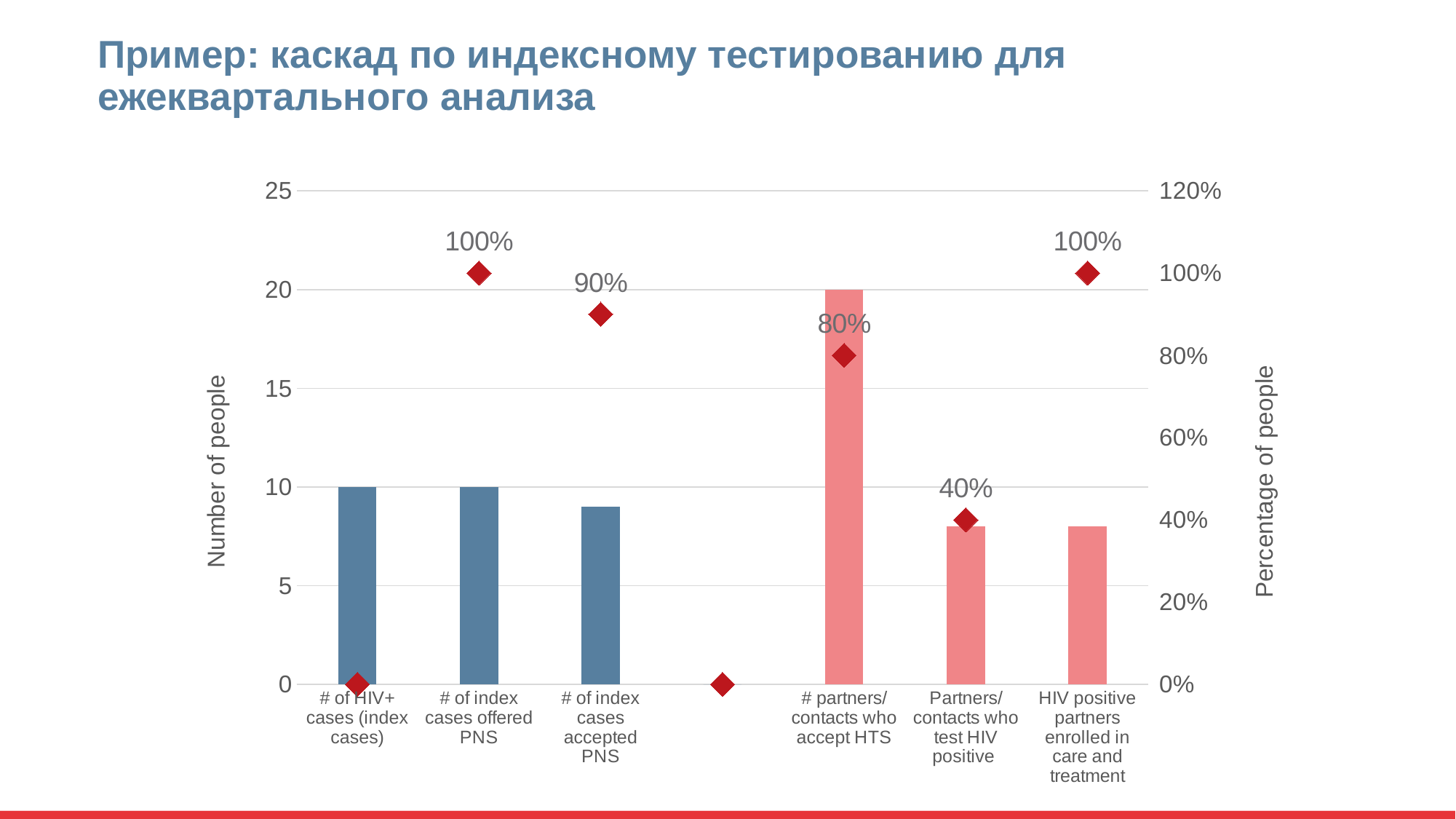
Which category has the tallest bar? # partners/contacts who accept HTS Which bar is taller: '# partners/contacts who accept HTS' or '# of HIV+ cases (index cases)'? # partners/contacts who accept HTS Is the number of people for 'Partners/contacts who test HIV positive' greater or less than 10? less What is the difference between the percentage for '# of index cases offered PNS' and the percentage for 'Partners/contacts who test HIV positive'? 60% What is the number of people for '# partners/contacts who accept HTS'? 20 What percentage is shown for '# of index cases accepted PNS'? 90% What is the title of the left vertical axis? Number of people Which category has the lowest percentage label? Partners/contacts who test HIV positive What is the number of people for '# of HIV+ cases (index cases)'? 10 What percentage is shown for '# partners/contacts who accept HTS'? 80% What percentage is shown for '# of index cases offered PNS'? 100% What percentage is shown for 'Partners/contacts who test HIV positive'? 40%